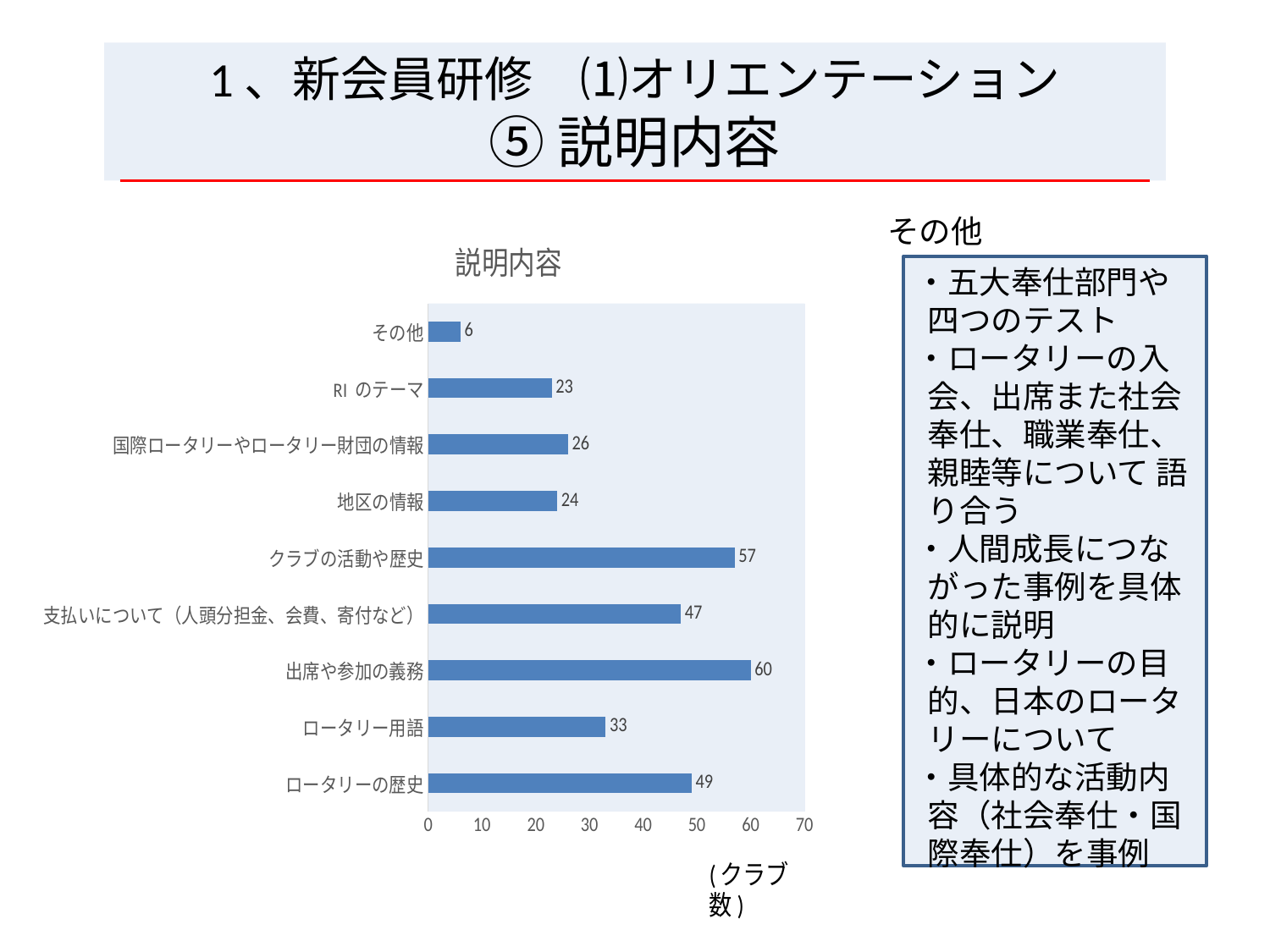
Which is larger, 支払いについて（人頭分担金、会費、寄付など） or ロータリーの歴史? ロータリーの歴史 Which category has the lowest value? その他 What is the difference between RI のテーマ and その他? 17 What is the value for ロータリーの歴史? 49 Is the value for 国際ロータリーやロータリー財団の情報 greater or less than 30? less Which category has the highest value? 出席や参加の義務 What is the title of the chart? 説明内容 What is the value for 地区の情報? 24 How many categories are shown in the chart? 9 What kind of chart is shown? bar chart What is the difference between クラブの活動や歴史 and ロータリー用語? 24 What is the value for 出席や参加の義務? 60